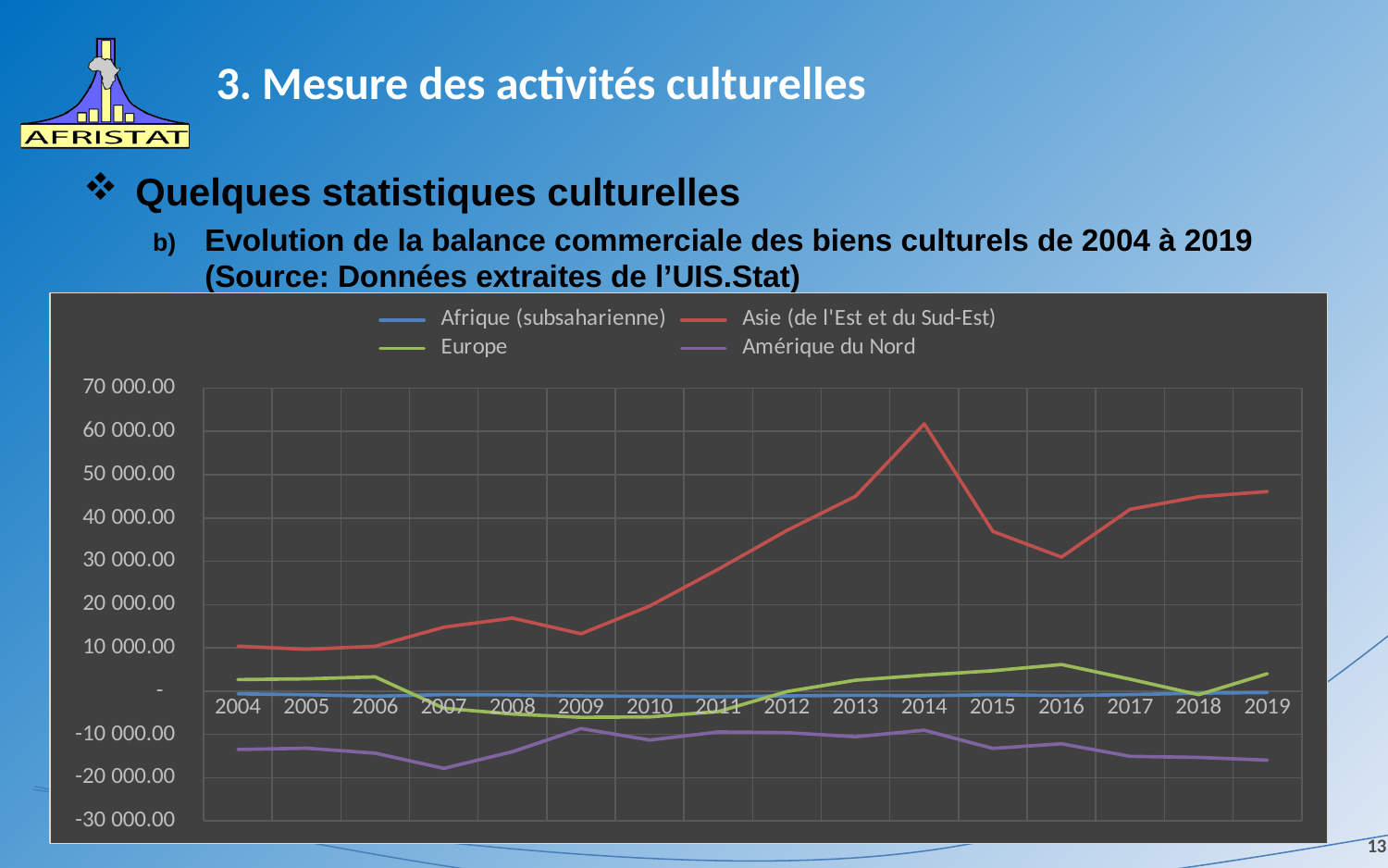
Is the value for Amérique du Nord in 2007 greater or less than -10 000.00? less In which year does the Asie (de l'Est et du Sud-Est) series reach its peak? 2014 Which series has the lowest value in 2007? Amérique du Nord How many series does the legend list? 4 Is the value for Asie (de l'Est et du Sud-Est) in 2019 greater or less than 40 000.00? greater How many years are plotted along the x axis? 16 Which series reaches the highest value on the chart? Asie (de l'Est et du Sud-Est) What kind of chart is shown on the slide? line chart Which is larger for Asie (de l'Est et du Sud-Est): the value in 2014 or the value in 2015? 2014 Does the Asie (de l'Est et du Sud-Est) series rise or fall between 2009 and 2014? rise Is the value for Asie (de l'Est et du Sud-Est) in 2014 greater or less than 50 000.00? greater Which series is shown in red in the legend? Asie (de l'Est et du Sud-Est)